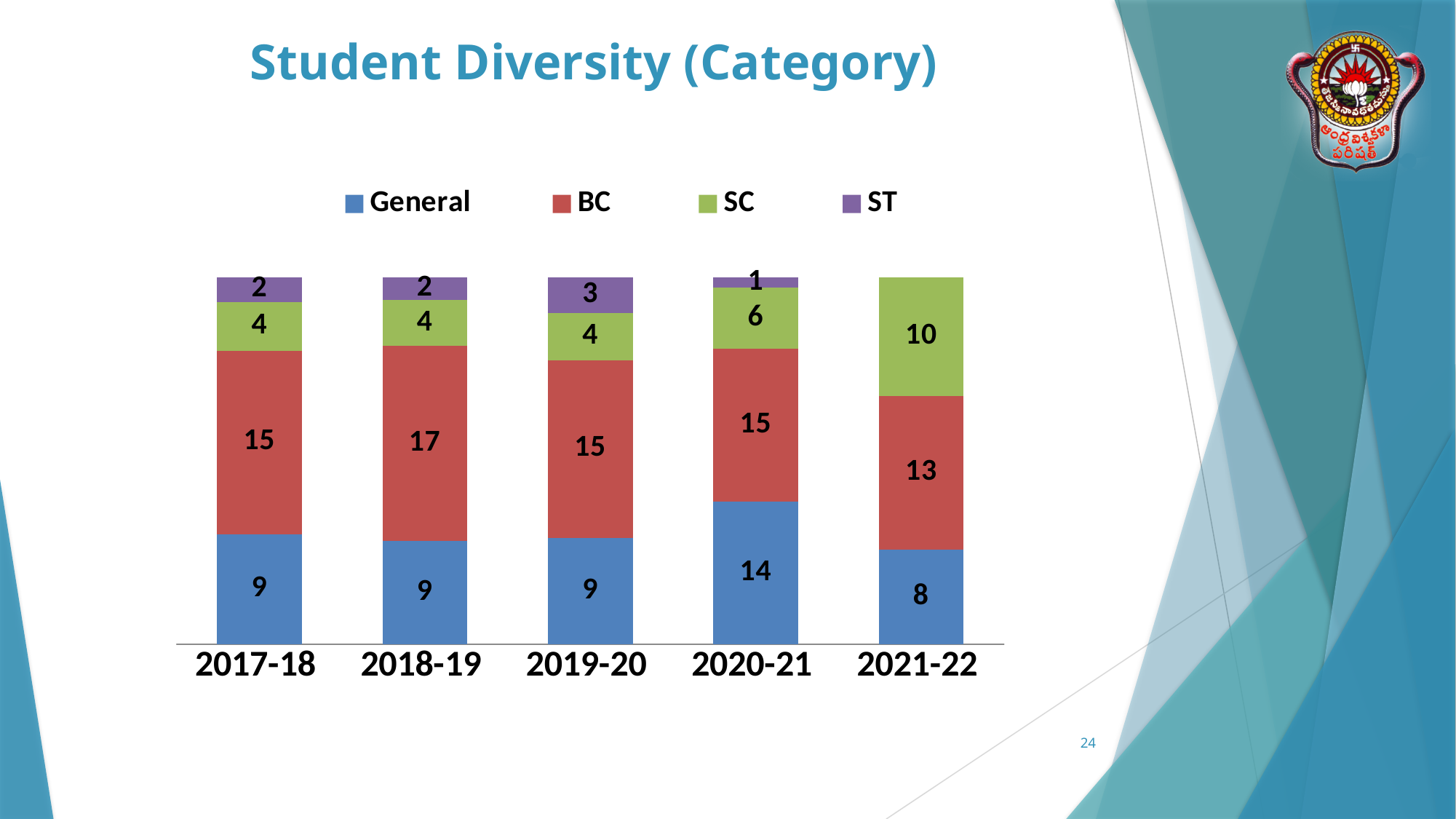
How many academic years are shown on the x axis? 5 In which year is the BC value the highest? 2018-19 What is the value for BC in 2018-19? 17 What kind of chart is shown on the slide? Stacked bar chart What is the value for SC in 2021-22? 10 In which year is the General value the lowest? 2021-22 How many series does the legend list? 4 What is the total of the stacked bar for 2017-18? 30 What is the value for ST in 2019-20? 3 What is the value for General in 2020-21? 14 What is the difference between the BC value in 2018-19 and the BC value in 2021-22? 4 Which is larger, the SC value in 2020-21 or the SC value in 2017-18? 2020-21